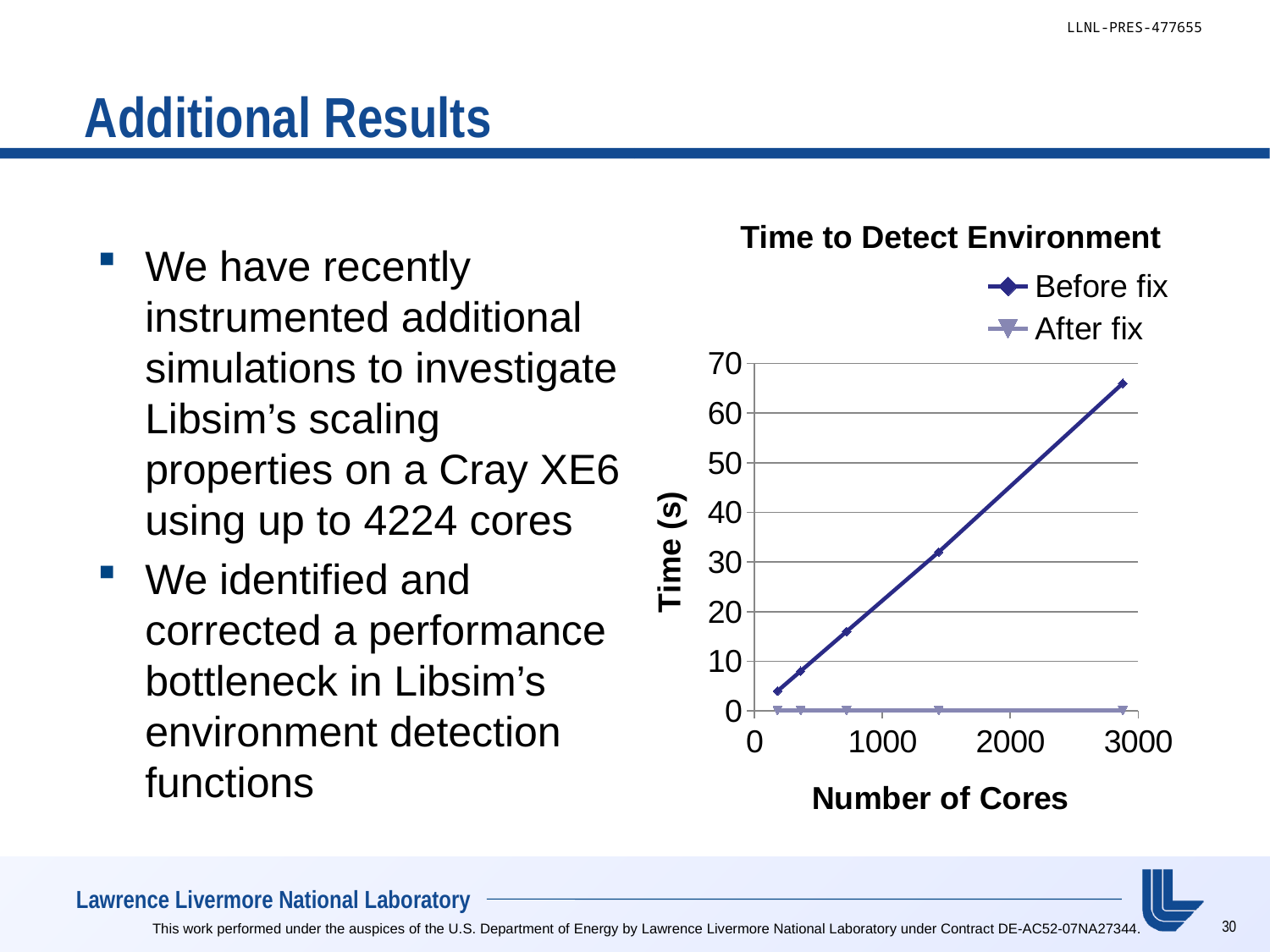
Which series has the higher time at around 1500 cores, Before fix or After fix? Before fix What is the title of the chart? Time to Detect Environment Is the value of the Before fix series at around 1500 cores greater or less than 20? greater What is the label of the y axis of the chart? Time (s) How many data points are plotted for the Before fix series? 5 Is the highest value of the Before fix series greater or less than 60? greater How many series does the legend of the chart list? 2 What kind of chart is shown on the slide? line chart Does the Before fix series rise or fall as the number of cores increases? rise Which series reaches the highest time on the chart? Before fix Is the value of the After fix series at around 3000 cores greater or less than 10? less Which series has the lowest times on the chart? After fix